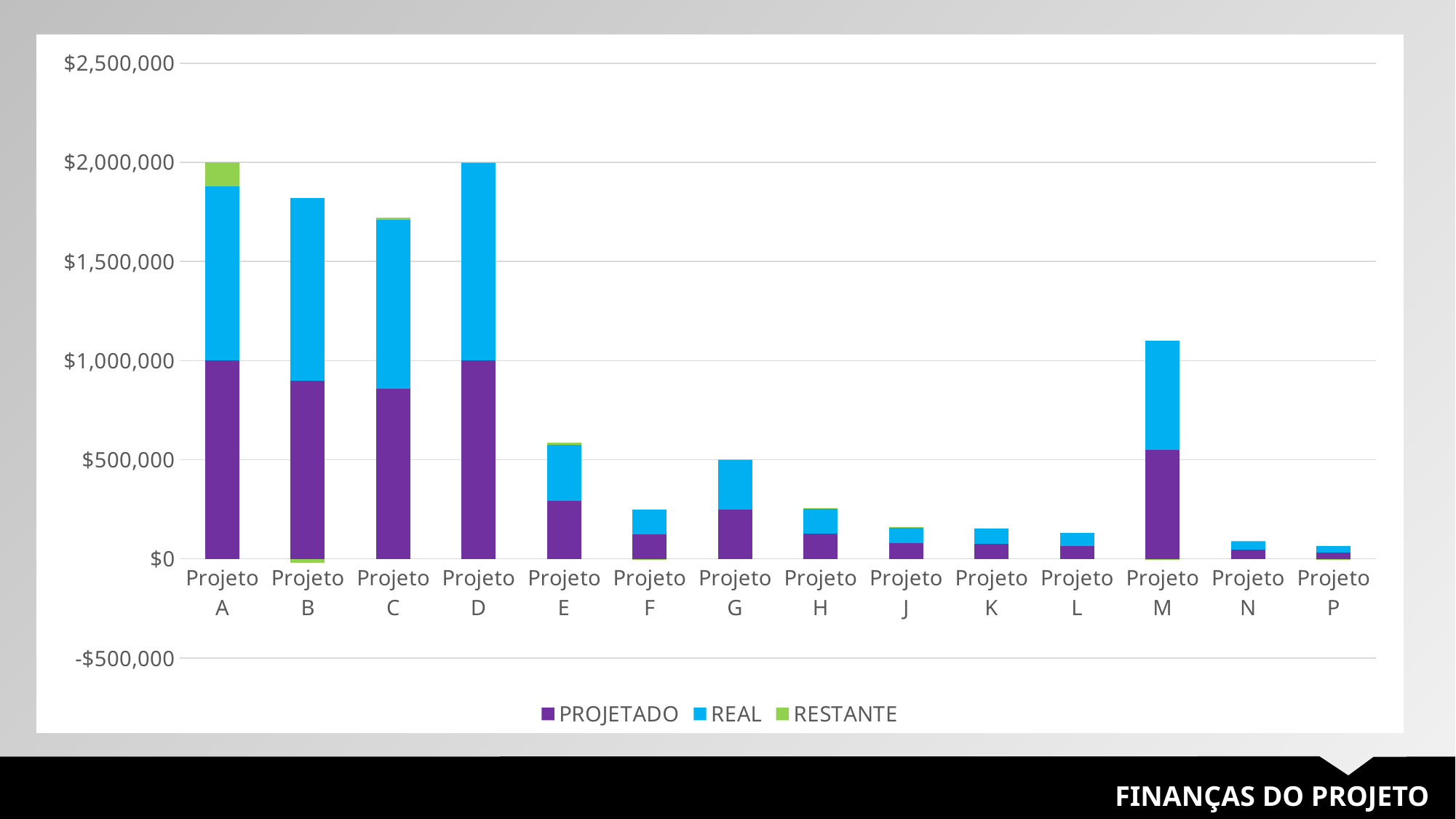
What is the PROJETADO value for Projeto A? $1,000,000 Is the total value for Projeto M greater or less than $1,000,000? greater What is the total height of the stacked bar for Projeto D? $2,000,000 How many series does the legend list? 3 What are the three series named in the legend? PROJETADO, REAL, RESTANTE Which has the larger total bar, Projeto M or Projeto E? Projeto M Is the total value for Projeto B greater or less than $1,500,000? greater What kind of chart is shown on the slide? Stacked bar chart Is the total value for Projeto F greater or less than $500,000? less Which colour represents the REAL series? Blue How many projects (categories) are plotted on the x axis? 14